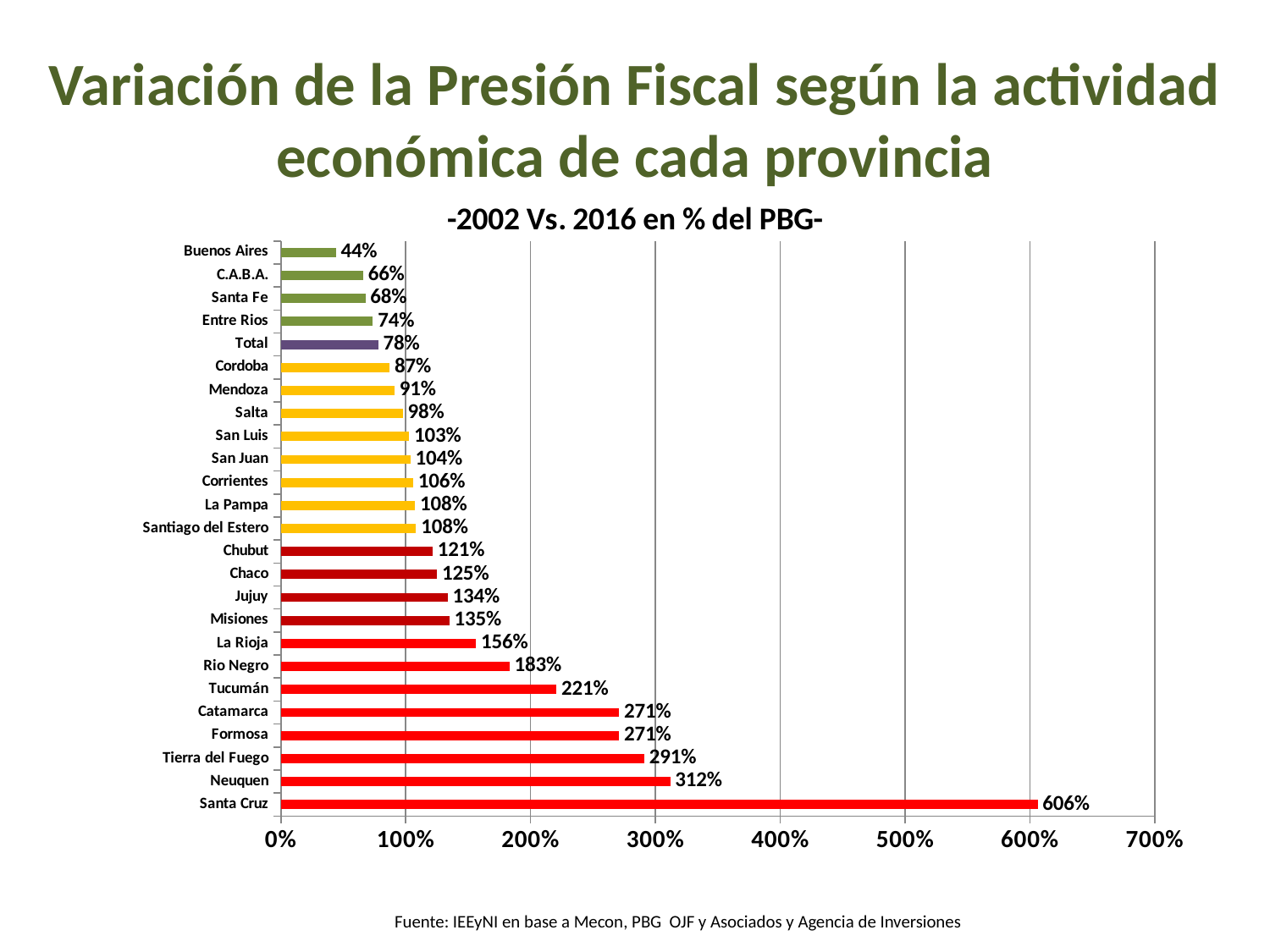
Which is larger, the value for Tucumán or the value for Rio Negro? Tucumán What kind of chart is shown on the slide? bar chart What is the difference between the values for Neuquen and Tierra del Fuego? 21% Is the value for Catamarca greater or less than 300%? less What is the subtitle shown above the chart? -2002 Vs. 2016 en % del PBG- What is the difference between the values for Santa Cruz and Buenos Aires? 562% How many bars are shown in the chart? 25 What is the value for Santa Cruz? 606% What is the value for Mendoza? 91% Which province has the highest value? Santa Cruz Which province has the lowest value? Buenos Aires What is the value for Total? 78%